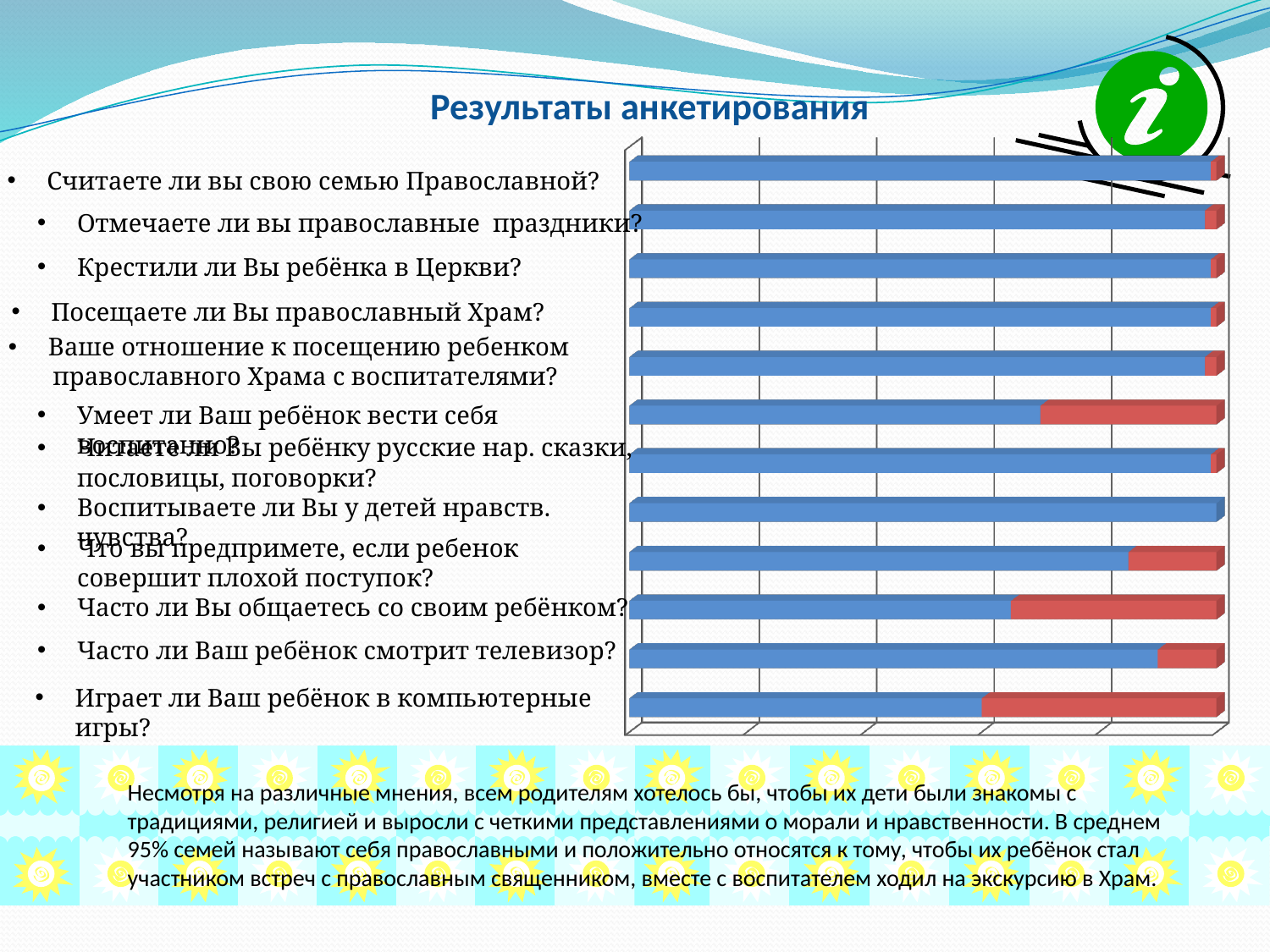
How many bars does the chart contain? 12 What kind of chart is shown on the slide? bar chart Is the blue segment longer for "Часто ли Вы общаетесь со своим ребёнком?" or for "Играет ли Ваш ребёнок в компьютерные игры?" Часто ли Вы общаетесь со своим ребёнком? What is the title shown above the chart on the slide? Результаты анкетирования Which question has the largest red segment in its bar? Играет ли Ваш ребёнок в компьютерные игры? Is the red segment larger for "Часто ли Вы общаетесь со своим ребёнком?" or for "Что вы предпримете, если ребенок совершит плохой поступок?" Часто ли Вы общаетесь со своим ребёнком? Is the red segment larger for "Играет ли Ваш ребёнок в компьютерные игры?" or for "Часто ли Ваш ребёнок смотрит телевизор?" Играет ли Ваш ребёнок в компьютерные игры? How many colours are used for the bar segments in the chart? 2 Which question has the shortest blue segment in its bar? Играет ли Ваш ребёнок в компьютерные игры?